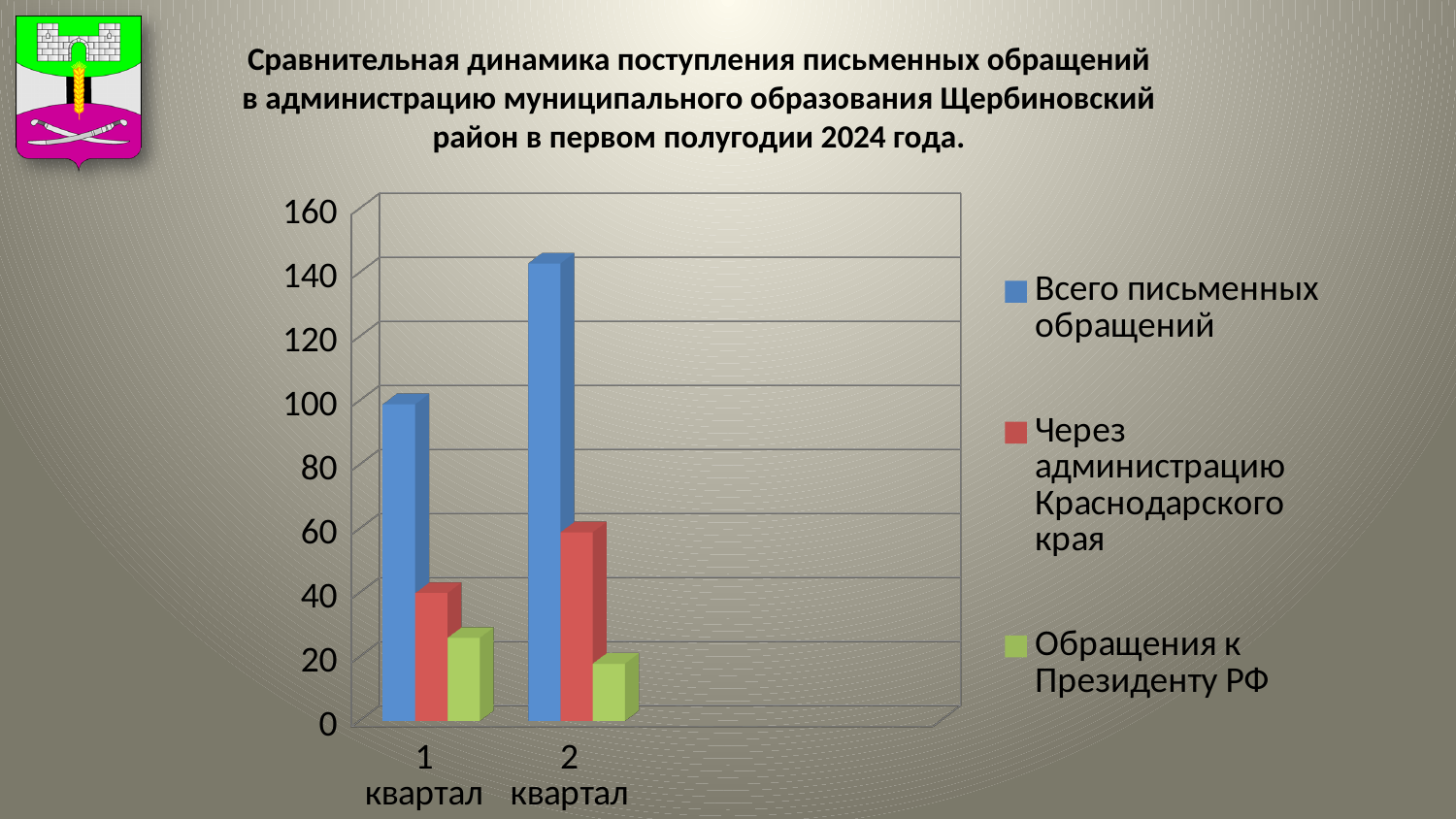
Is the value for Всего письменных обращений in 1 квартал greater or less than 120? less What kind of chart is shown on the slide? Bar chart Does the value for Всего письменных обращений rise or fall from 1 квартал to 2 квартал? rise Which series is shown in green? Обращения к Президенту РФ Is the value for Через администрацию Краснодарского края in 2 квартал greater or less than 40? greater Which series is shown in blue? Всего письменных обращений In which quarter is the value for Всего письменных обращений higher? 2 квартал In which quarter is the value for Обращения к Президенту РФ higher? 1 квартал Is the value for Обращения к Президенту РФ in 2 квартал greater or less than 40? less How many categories are shown on the x axis? 2 How many series does the legend list? 3